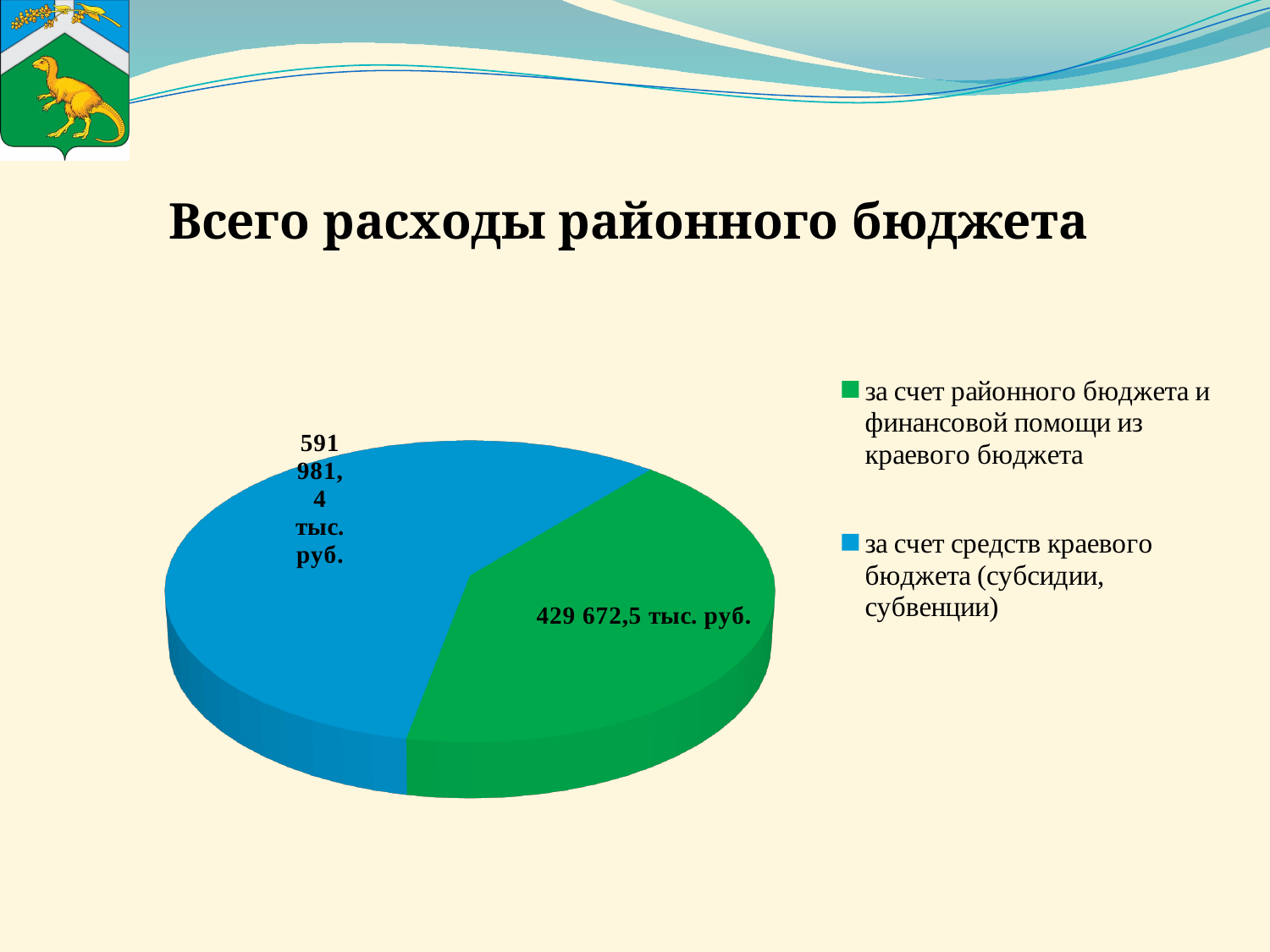
What is the difference between the two slice values, 591 981,4 and 429 672,5 тыс. руб.? 162 308,9 тыс. руб. How many slices does the pie chart have? 2 What colour is the slice for 'за счет районного бюджета и финансовой помощи из краевого бюджета'? Green Which slice of the pie chart is the largest? за счет средств краевого бюджета (субсидии, субвенции) What is the title of the chart on the slide? Всего расходы районного бюджета What value is shown for the slice 'за счет средств краевого бюджета (субсидии, субвенции)'? 591 981,4 тыс. руб. What is the total of the two slice values shown on the pie chart? 1 021 653,9 тыс. руб. What kind of chart is shown on the slide? Pie chart Which is larger: the slice for 'за счет средств краевого бюджета (субсидии, субвенции)' or the slice for 'за счет районного бюджета и финансовой помощи из краевого бюджета'? за счет средств краевого бюджета (субсидии, субвенции) How many entries does the legend list? 2 What value is shown for the slice 'за счет районного бюджета и финансовой помощи из краевого бюджета'? 429 672,5 тыс. руб. Which slice of the pie chart is the smallest? за счет районного бюджета и финансовой помощи из краевого бюджета